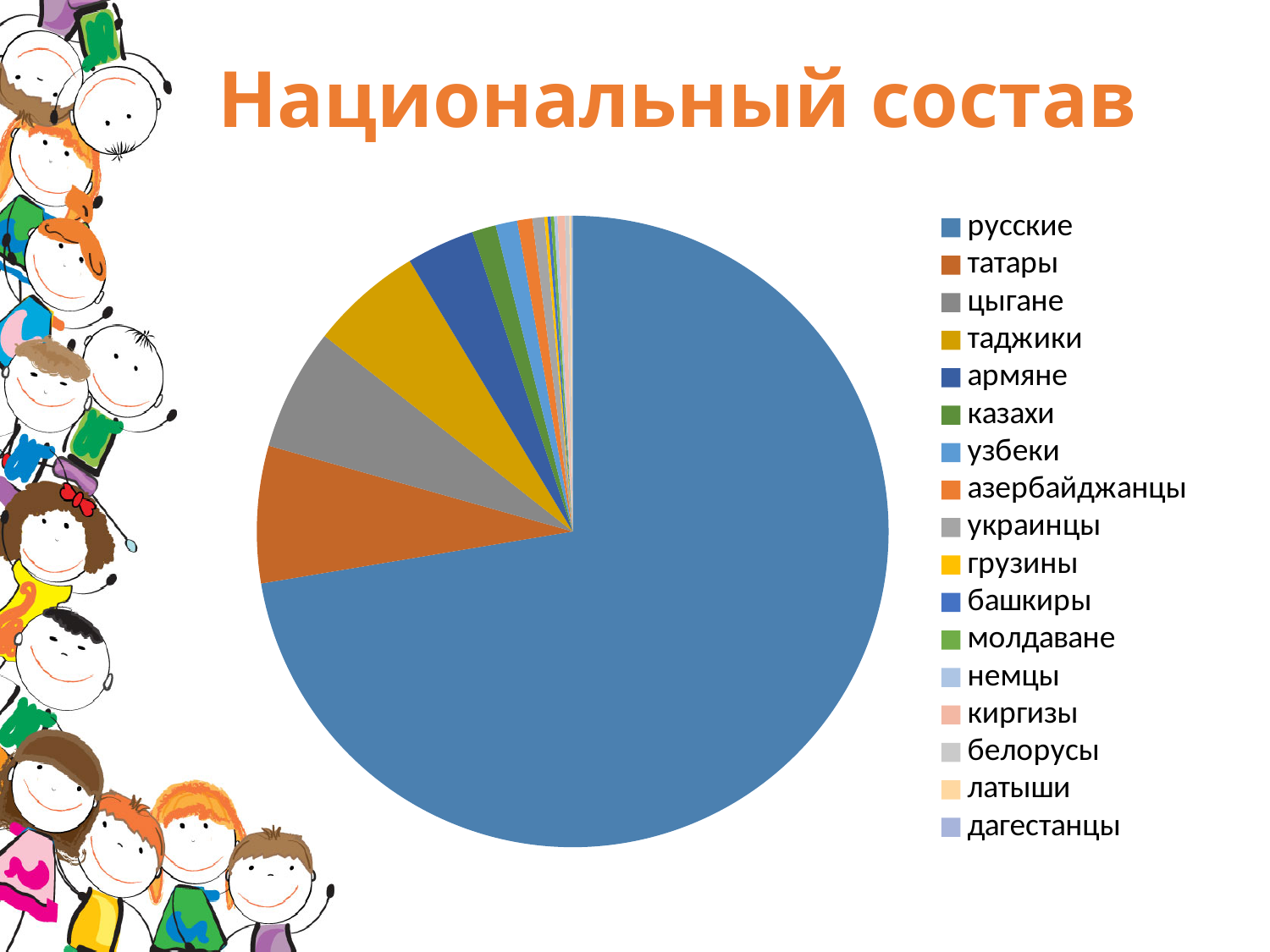
Which category has the largest slice of the pie chart? русские Which slice is larger, таджики or армяне? таджики Which category is listed first in the legend of the pie chart? русские Is the русские slice larger than all the other slices combined? yes Which slice is larger, русские or татары? русские How many categories does the legend of the pie chart list? 17 Which category is listed last in the legend of the pie chart? дагестанцы What kind of chart is shown on the slide? pie chart What is the title of the chart on the slide? Национальный состав